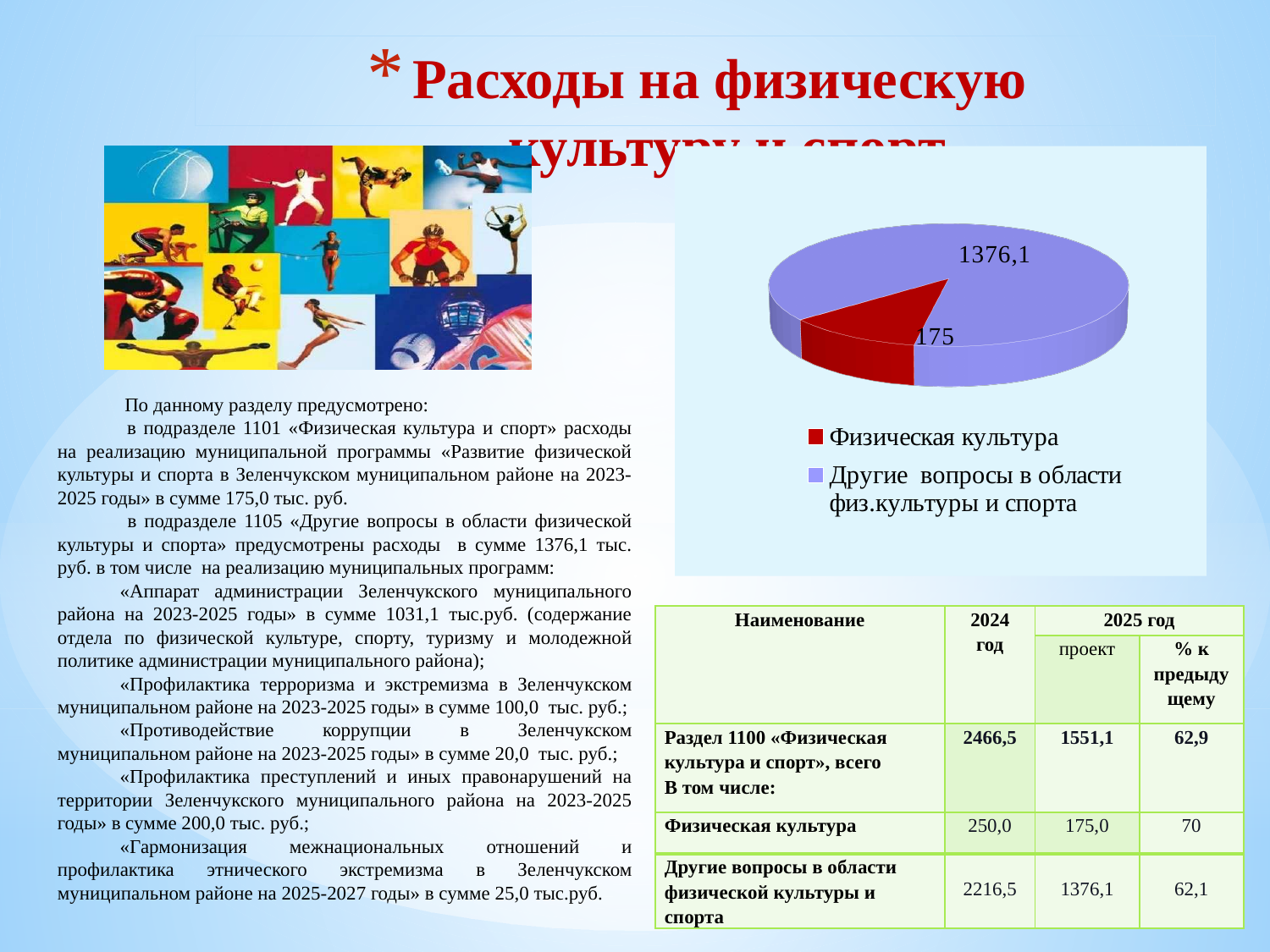
How many entries does the legend of the pie chart list? 2 What is the total of the two values shown in the pie chart? 1551,1 Is the value for «Физическая культура» in the pie chart greater or less than 1000? less What value is shown for the «Физическая культура» slice of the pie chart? 175 What is the difference between the two values shown in the pie chart? 1201,1 Which is larger in the pie chart: «Физическая культура» or «Другие вопросы в области физ.культуры и спорта»? Другие вопросы в области физ.культуры и спорта What kind of chart is shown on the slide? Pie chart Which category has the largest slice in the pie chart? Другие вопросы в области физ.культуры и спорта Which category has the smallest slice in the pie chart? Физическая культура How many slices does the pie chart have? 2 What colour is the «Физическая культура» slice in the pie chart? Red What value is shown for the «Другие вопросы в области физ.культуры и спорта» slice of the pie chart? 1376,1